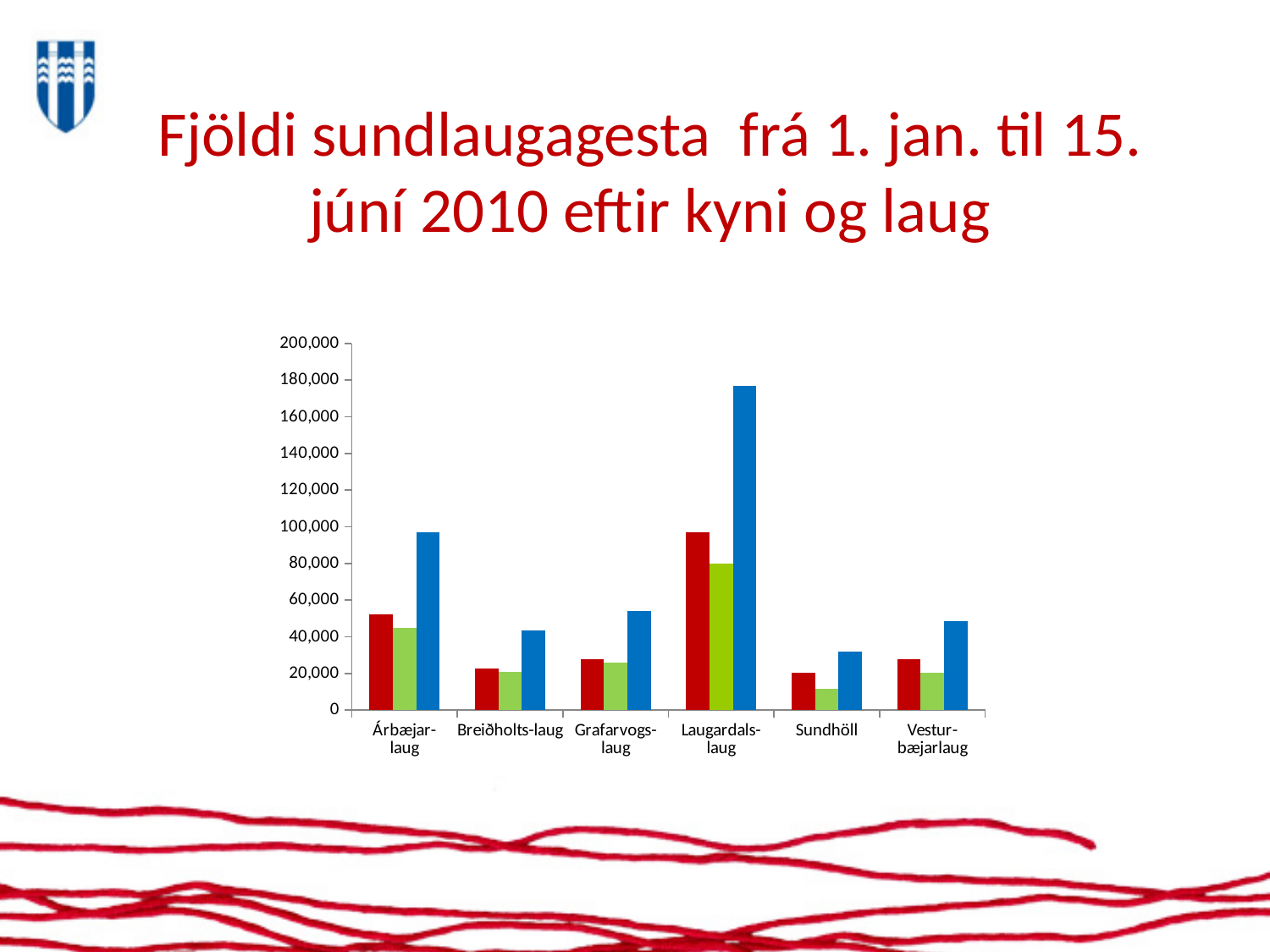
Which swimming pool has the lowest blue bar? Sundhöll Is the blue bar for Laugardalslaug greater or less than 160,000? greater Which swimming pool has the lowest green bar? Sundhöll What is the title of the slide? Fjöldi sundlaugagesta frá 1. jan. til 15. júní 2010 eftir kyni og laug Which is larger, the red bar for Árbæjarlaug or the red bar for Grafarvogslaug? Árbæjarlaug How many swimming pools (categories) are shown on the x axis? 6 Is the green bar for Laugardalslaug greater or less than 60,000? greater Which swimming pool has the tallest blue bar? Laugardalslaug How many bars are plotted for each swimming pool? 3 Is the green bar for Sundhöll greater or less than 20,000? less What kind of chart is shown on the slide? bar chart